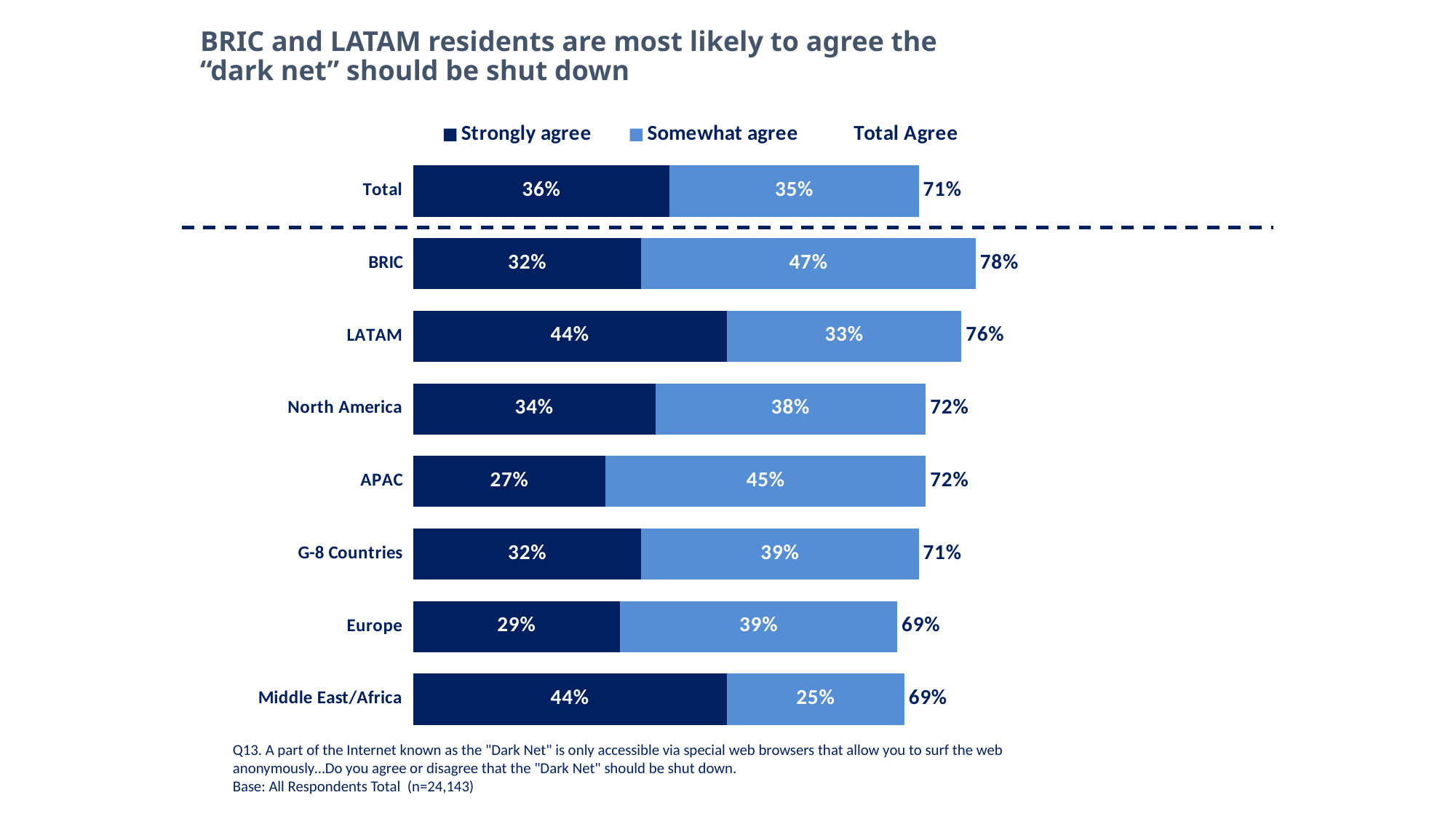
What is the difference between the Strongly agree values for LATAM and APAC? 17% What kind of chart is shown on the slide? Stacked bar chart What is the Total Agree value for LATAM? 76% How many series does the legend list as coloured bar segments? 2 What percentage of BRIC residents somewhat agree the dark net should be shut down? 47% How many regions are shown below the dashed line, excluding Total? 7 Which region has the lowest Somewhat agree value? Middle East/Africa What is the base size (n) stated at the bottom of the slide? n=24,143 Which is larger, the Somewhat agree value for APAC or for North America? APAC What is the Strongly agree value for Middle East/Africa? 44% What is the total of the stacked bar for Europe? 69% Which region has the highest Total Agree value? BRIC